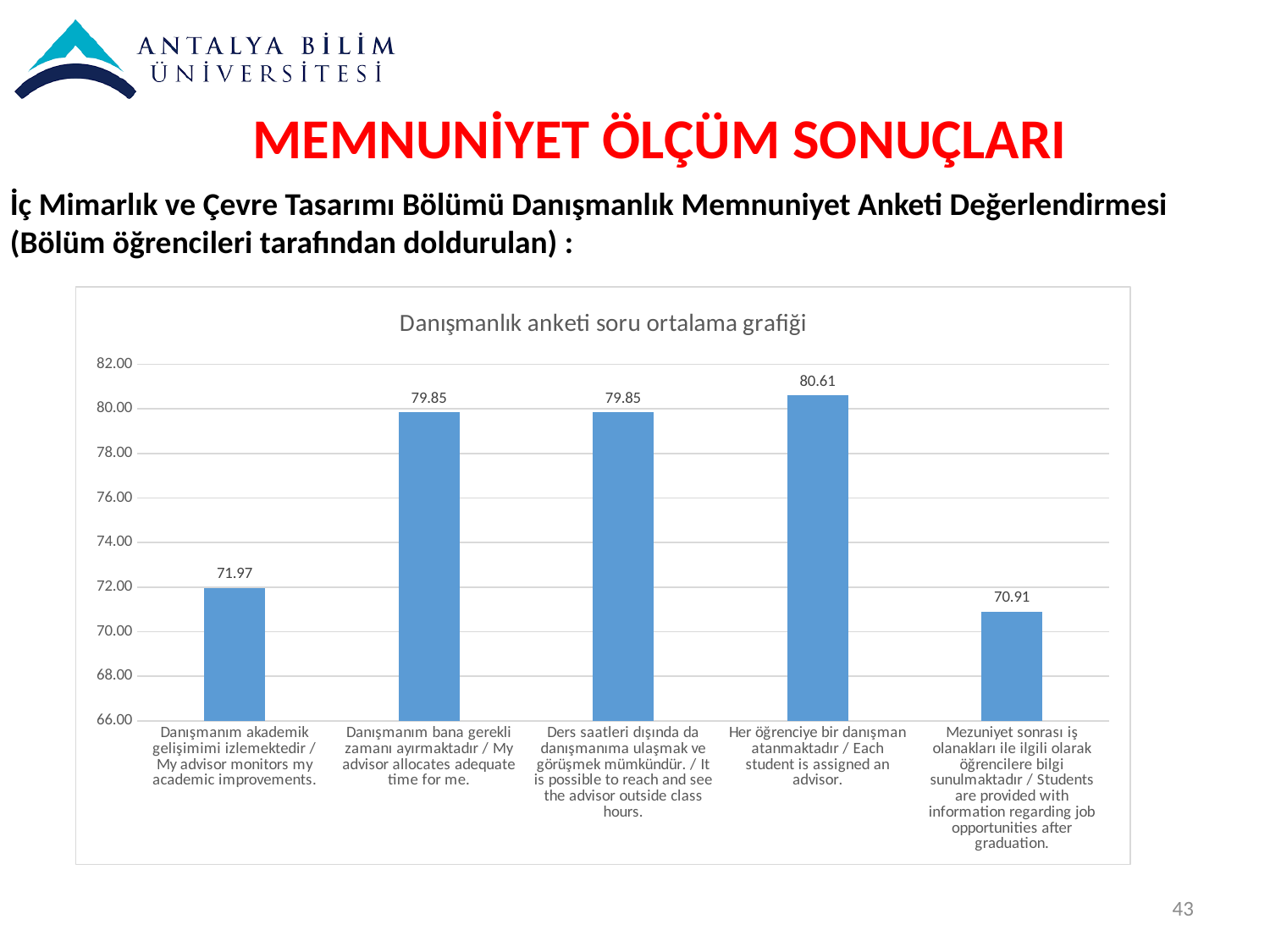
Which is larger: the value for "My advisor monitors my academic improvements" or the value for "Students are provided with information regarding job opportunities after graduation"? My advisor monitors my academic improvements How many categories are shown in the chart? 5 What is the difference between the highest value (80.61) and the lowest value (70.91)? 9.70 Which category has the lowest value? Mezuniyet sonrası iş olanakları ile ilgili olarak öğrencilere bilgi sunulmaktadır / Students are provided with information regarding job opportunities after graduation. What is the value for "Danışmanım bana gerekli zamanı ayırmaktadır / My advisor allocates adequate time for me."? 79.85 What is the title of the chart? Danışmanlık anketi soru ortalama grafiği What kind of chart is shown on the slide? Bar chart What is the value for "Her öğrenciye bir danışman atanmaktadır / Each student is assigned an advisor."? 80.61 What is the value for "Mezuniyet sonrası iş olanakları ile ilgili olarak öğrencilere bilgi sunulmaktadır / Students are provided with information regarding job opportunities after graduation."? 70.91 What is the value for "Danışmanım akademik gelişimimi izlemektedir / My advisor monitors my academic improvements."? 71.97 What is the difference between the value for "Each student is assigned an advisor" and the value for "My advisor allocates adequate time for me"? 0.76 Which category has the highest value? Her öğrenciye bir danışman atanmaktadır / Each student is assigned an advisor.